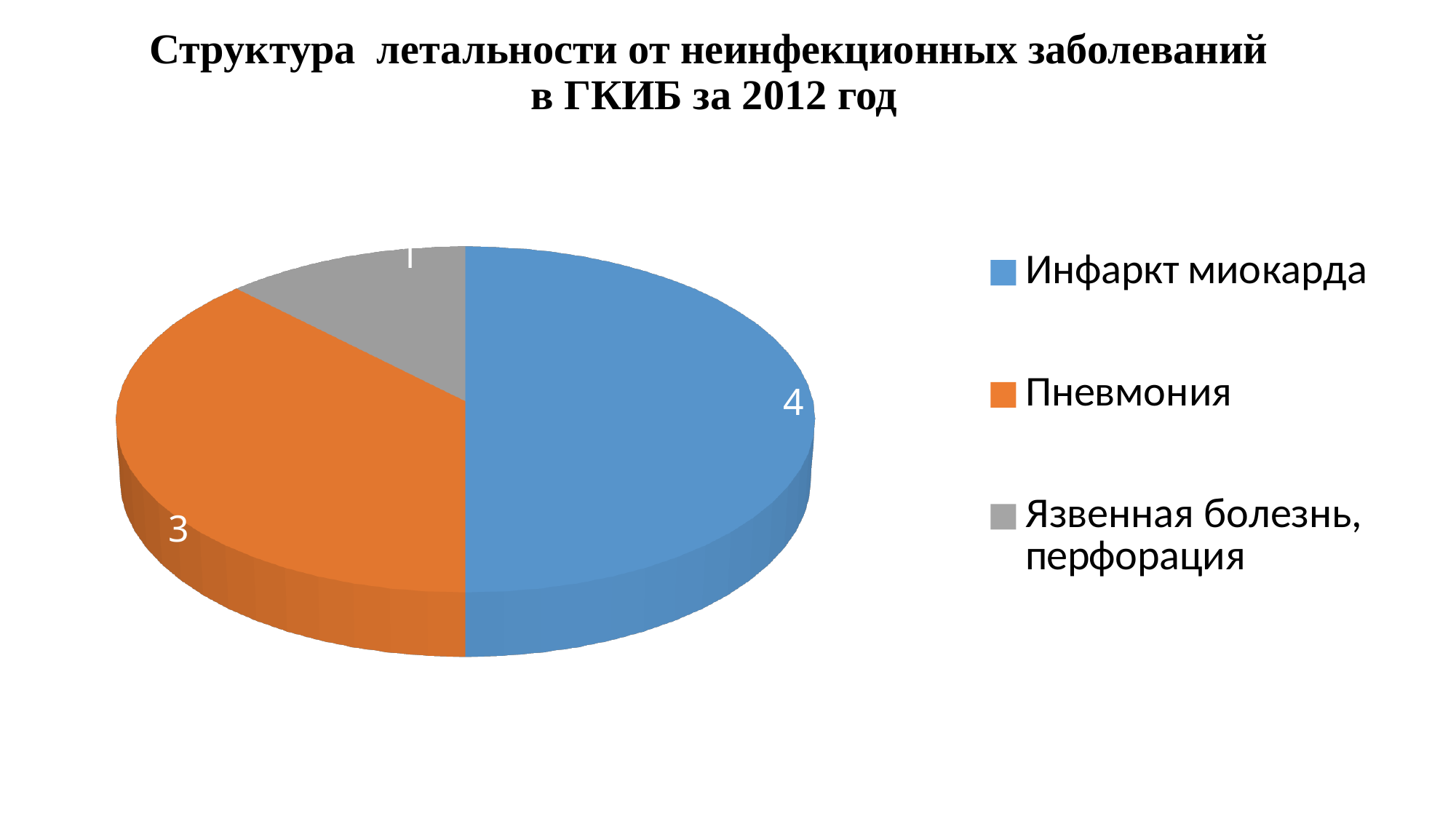
What is the value for Язвенная болезнь, перфорация? 1 What share of the pie does Инфаркт миокарда represent? 50% Which category has the largest slice? Инфаркт миокарда Which is larger, the value for Пневмония or the value for Язвенная болезнь, перфорация? Пневмония How many categories does the pie chart have? 3 What is the value for Инфаркт миокарда? 4 What is the value for Пневмония? 3 What type of chart is shown on the slide? Pie chart What colour is the slice for Пневмония? Orange Which category has the smallest slice? Язвенная болезнь, перфорация What is the total of all slices in the pie chart? 8 What is the difference between the values for Инфаркт миокарда and Пневмония? 1